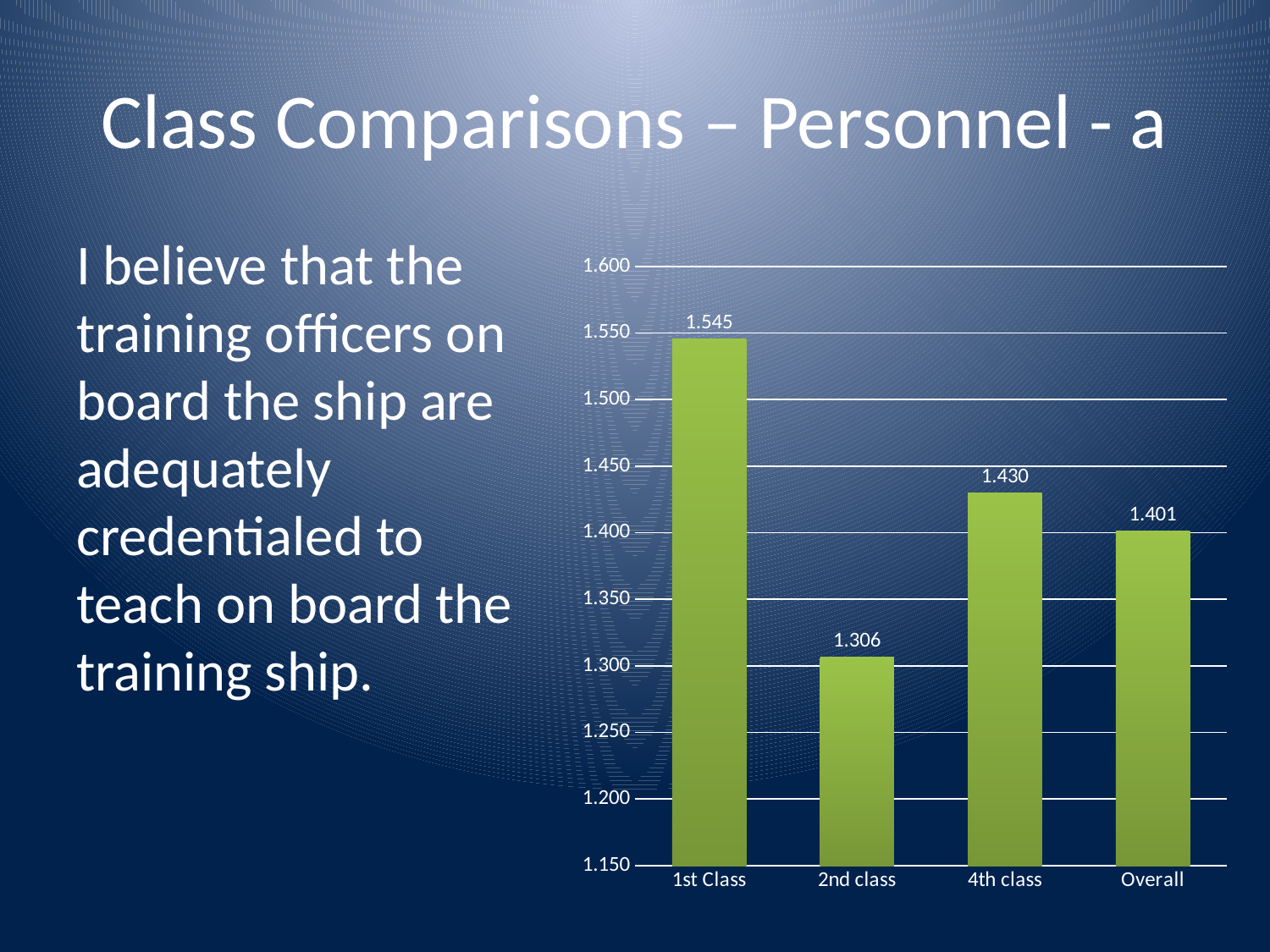
How many categories are shown on the x axis? 4 What is the value for Overall? 1.401 Is the value for 2nd class greater or less than 1.350? less What is the value for 4th class? 1.430 What is the value for 1st Class? 1.545 What is the value for 2nd class? 1.306 Which category has the highest value? 1st Class Which is larger, the value for 4th class or the value for Overall? 4th class What kind of chart is shown on the slide? bar chart Which category has the lowest value? 2nd class What is the difference between the values for 1st Class and 2nd class? 0.239 What is the difference between the values for 4th class and Overall? 0.029